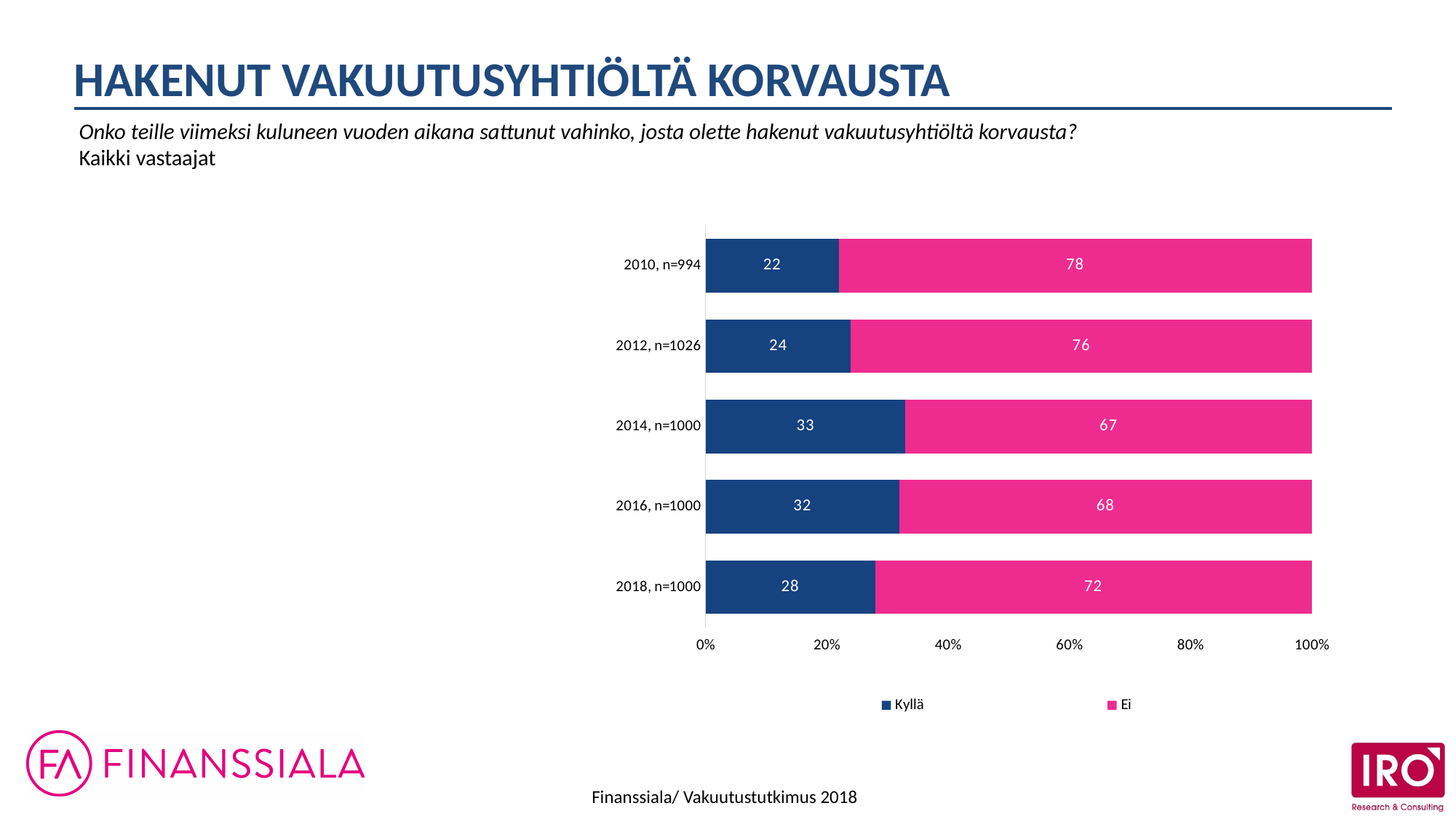
Which is larger, the Kyllä value for 2012, n=1026 or for 2016, n=1000? 2016, n=1000 Which category has the lowest Kyllä value? 2010, n=994 Which category has the highest Kyllä value? 2014, n=1000 What is the value for Kyllä in 2018, n=1000? 28 What kind of chart is shown on the slide? Stacked bar chart How many series does the legend list? 2 How many categories are shown on the chart? 5 What is the total of the stacked bar for 2016, n=1000? 100 What is the value for Kyllä in 2010, n=994? 22 What is the difference between the Ei values for 2010, n=994 and 2018, n=1000? 6 What is the value for Ei in 2014, n=1000? 67 Which series is shown in pink? Ei